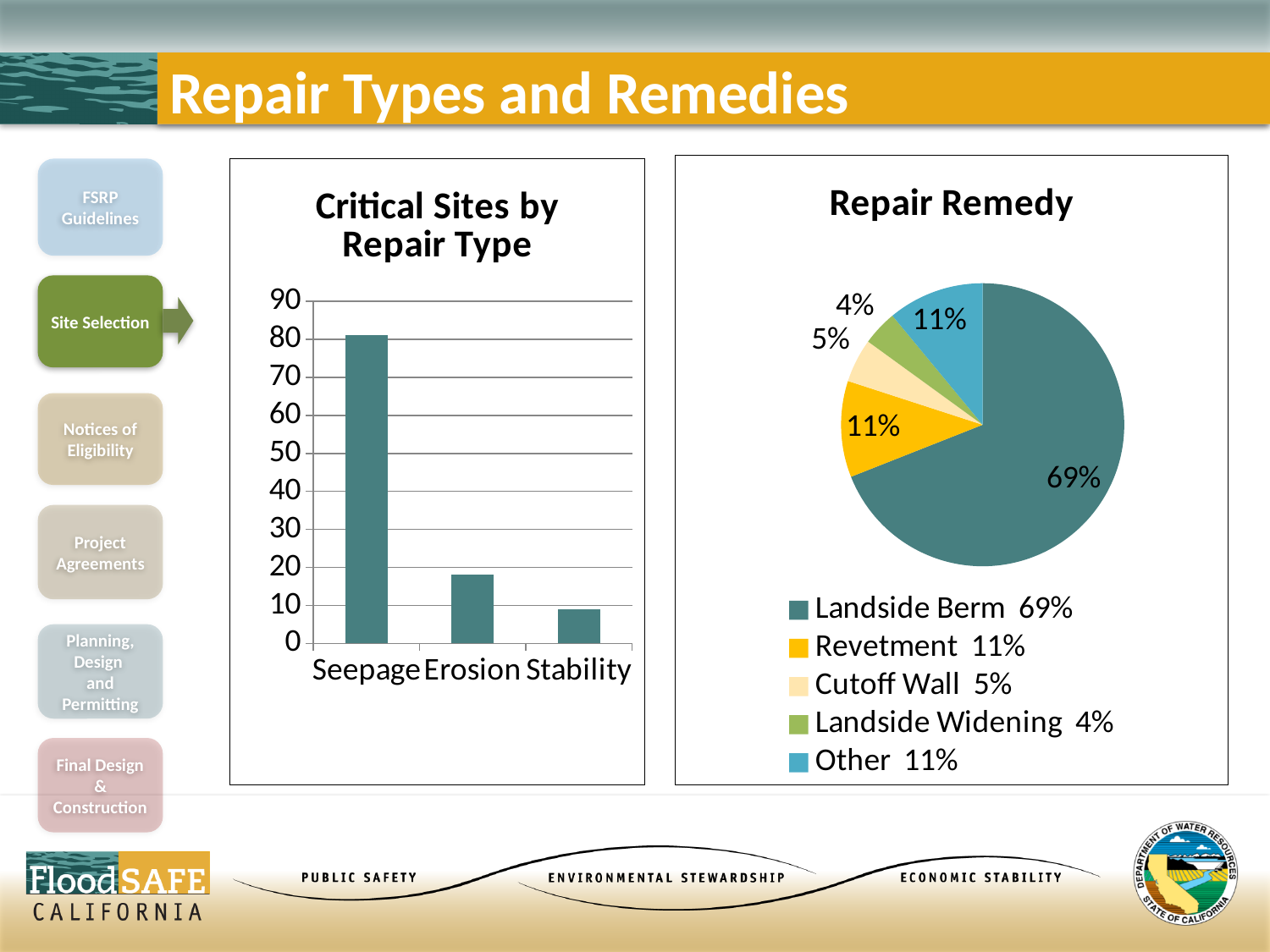
In the Repair Remedy pie chart, what share does Landside Berm have? 69% In the Critical Sites by Repair Type chart, is the value for Seepage greater or less than 70? greater In the Repair Remedy pie chart, what is the difference in percentage points between Revetment and Landside Widening? 7% In the Critical Sites by Repair Type chart, which repair type has the highest number of critical sites? Seepage In the Critical Sites by Repair Type chart, is the value for Erosion greater or less than 30? less In the Repair Remedy pie chart, how many remedies does the legend list? 5 In the Critical Sites by Repair Type chart, which repair type has the lowest number of critical sites? Stability In the Critical Sites by Repair Type chart, how many repair types are shown on the x axis? 3 In the Repair Remedy pie chart, what share does Cutoff Wall have? 5% What kind of chart is the Critical Sites by Repair Type chart? bar chart In the Repair Remedy pie chart, which remedy has the smallest share? Landside Widening In the Critical Sites by Repair Type chart, is the value for Stability greater or less than 20? less